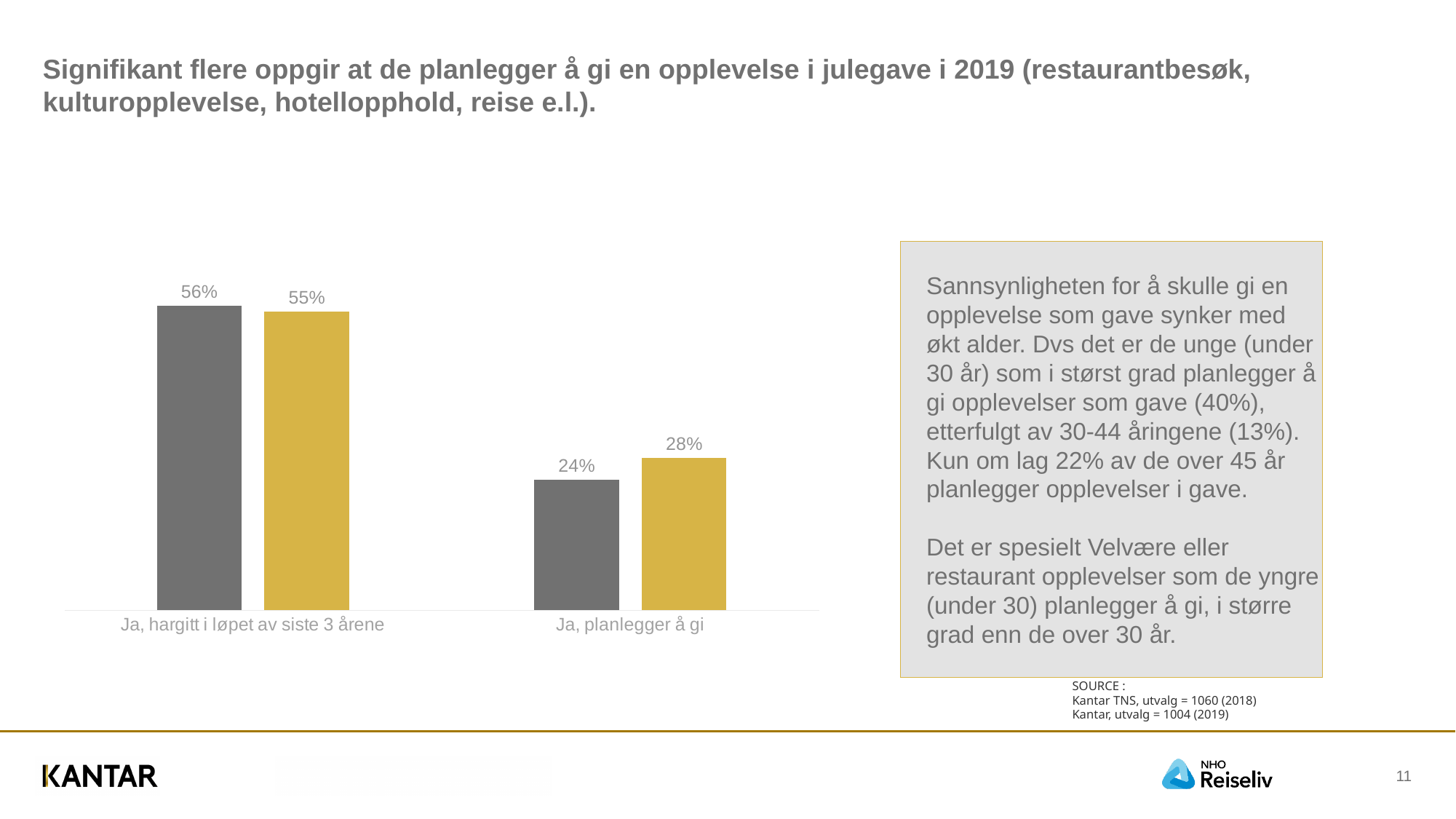
What value does the gold bar show for "Ja, hargitt i løpet av siste 3 årene"? 55% What is the difference between the gold bar and the grey bar for "Ja, planlegger å gi"? 4 percentage points Which bar in the chart has the lowest value? the grey bar for "Ja, planlegger å gi" (24%) What are the two colours used for the bars in the chart? grey and gold How many categories are shown on the x axis of the chart? 2 For "Ja, planlegger å gi", which bar is larger, the grey one or the gold one? the gold one Which bar in the chart has the highest value? the grey bar for "Ja, hargitt i løpet av siste 3 årene" (56%) What value does the gold bar show for "Ja, planlegger å gi"? 28% What is the difference between the grey bar and the gold bar for "Ja, hargitt i løpet av siste 3 årene"? 1 percentage point What value does the grey bar show for "Ja, planlegger å gi"? 24% What kind of chart is shown on the slide? bar chart What value does the grey bar show for "Ja, hargitt i løpet av siste 3 årene"? 56%